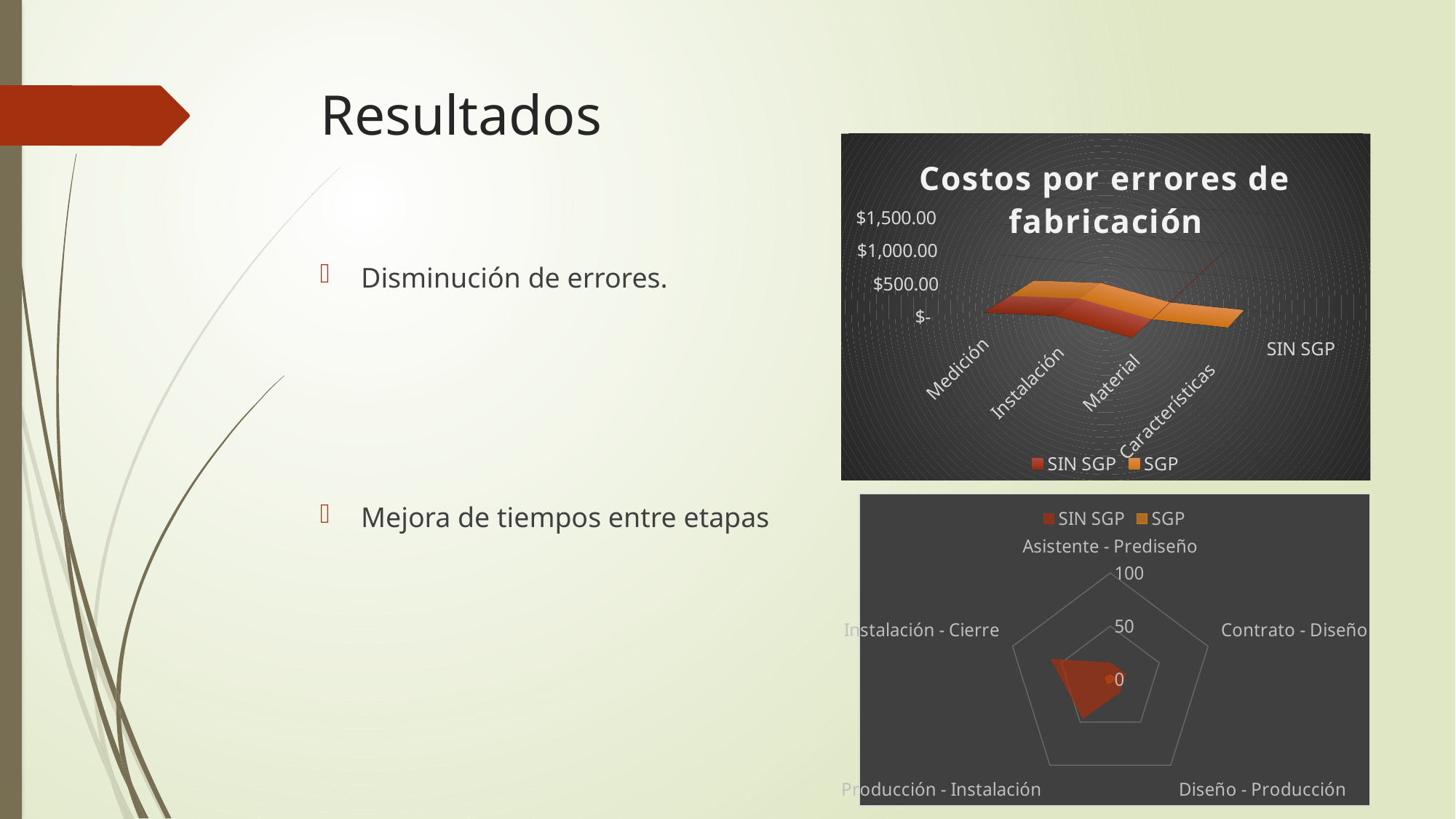
In the top chart 'Costos por errores de fabricación', is the SIN SGP value for Medición greater or less than $1,000.00? less How many series does the legend of the bottom radar chart list? 2 How many categories (axes) does the bottom radar chart have? 5 Which series are listed in the legend of the bottom radar chart? SIN SGP and SGP In the top chart 'Costos por errores de fabricación', is the SGP value for Material greater or less than $1,000.00? less How many categories are shown along the category axis of the top chart 'Costos por errores de fabricación'? 4 What kind of chart is the top chart, 'Costos por errores de fabricación'? 3D line chart How many series does the legend of the top chart 'Costos por errores de fabricación' list? 2 What kind of chart is the bottom chart on the slide? Radar chart What is the title of the top chart? Costos por errores de fabricación In the bottom radar chart, is the SIN SGP value for Contrato - Diseño greater or less than 50? less